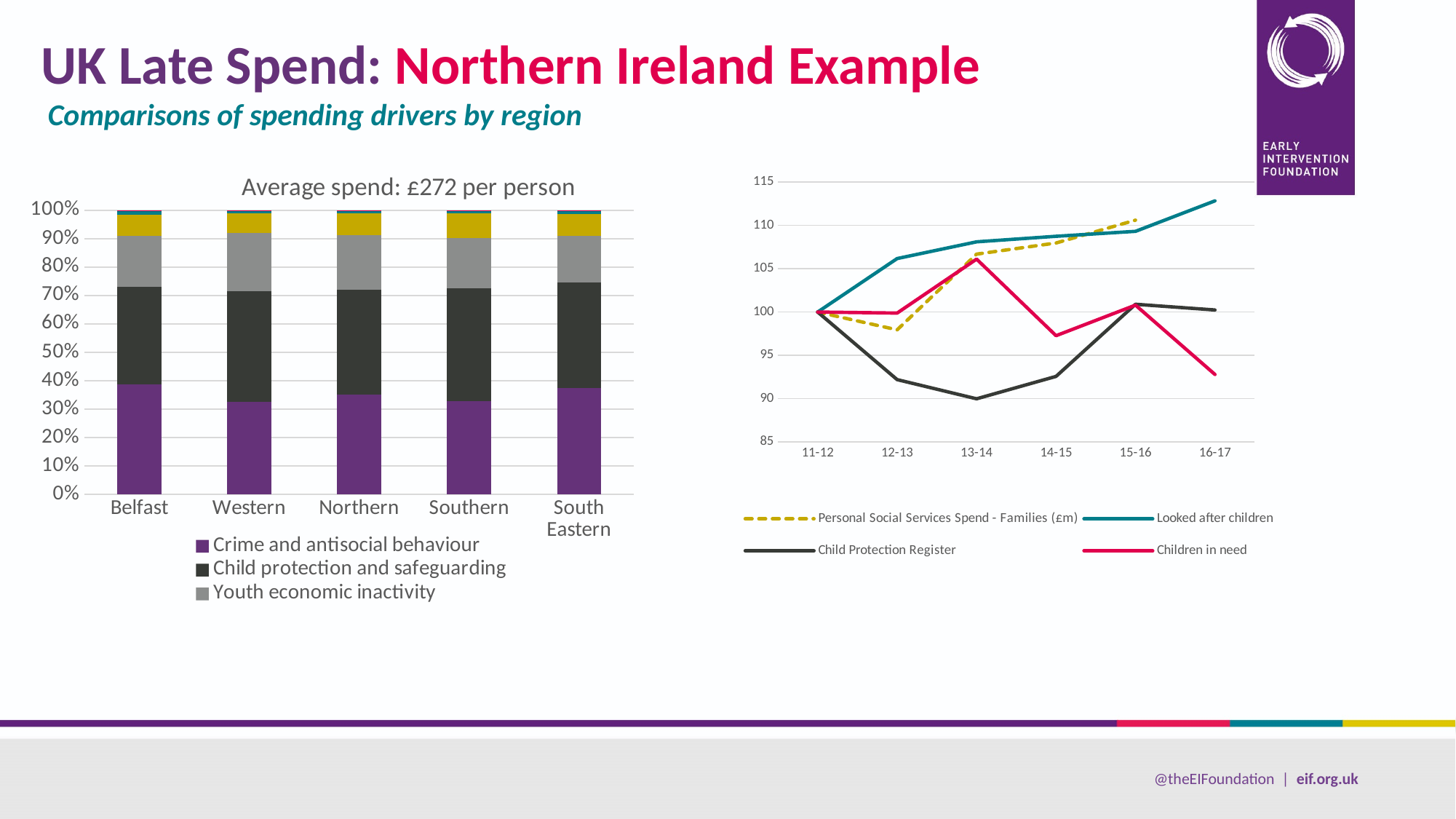
What kind of chart is the right chart on the slide? Line chart In the right chart, what is the value of 'Child Protection Register' in 13-14? 90 In the right chart, is the value of 'Looked after children' in 16-17 greater or less than 110? greater How many years are shown on the x axis of the right chart? 6 How many regions are shown on the x axis of the left chart titled 'Average spend: £272 per person'? 5 In the right chart, which series has the lowest value in 13-14? Child Protection Register In the left chart titled 'Average spend: £272 per person', is the 'Crime and antisocial behaviour' share for Belfast greater or less than 30%? greater What is the title of the left chart? Average spend: £272 per person How many series does the legend of the left chart titled 'Average spend: £272 per person' list? 3 How many series does the legend of the right chart list? 4 What kind of chart is the left chart titled 'Average spend: £272 per person'? Stacked bar chart In the right chart, what is the value of 'Looked after children' in 11-12? 100